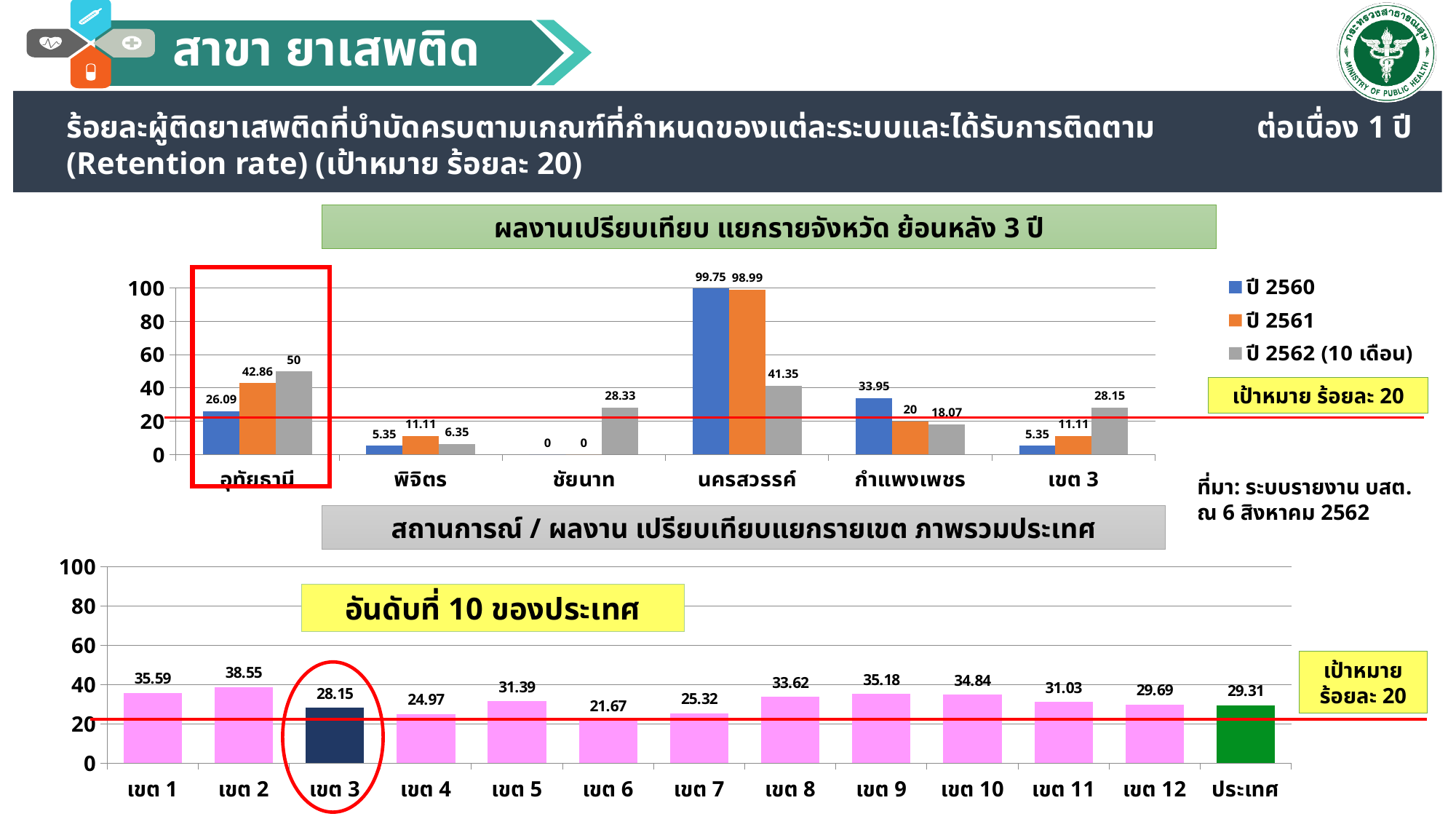
In the top chart (ผลงานเปรียบเทียบ แยกรายจังหวัด ย้อนหลัง 3 ปี), what is the value for นครสวรรค์ in ปี 2560? 99.75 In the bottom chart (สถานการณ์ / ผลงาน เปรียบเทียบแยกรายเขต ภาพรวมประเทศ), which is larger, the value for เขต 3 or the value for ประเทศ? ประเทศ In the bottom chart (สถานการณ์ / ผลงาน เปรียบเทียบแยกรายเขต ภาพรวมประเทศ), which category has the lowest value? เขต 6 In the bottom chart (สถานการณ์ / ผลงาน เปรียบเทียบแยกรายเขต ภาพรวมประเทศ), which category has the highest value? เขต 2 In the top chart (ผลงานเปรียบเทียบ แยกรายจังหวัด ย้อนหลัง 3 ปี), do the values for อุทัยธานี rise or fall from ปี 2560 to ปี 2562 (10 เดือน)? rise In the bottom chart (สถานการณ์ / ผลงาน เปรียบเทียบแยกรายเขต ภาพรวมประเทศ), how many categories are shown on the x axis? 13 In the top chart (ผลงานเปรียบเทียบ แยกรายจังหวัด ย้อนหลัง 3 ปี), what is the value for อุทัยธานี in ปี 2562 (10 เดือน)? 50 In the top chart (ผลงานเปรียบเทียบ แยกรายจังหวัด ย้อนหลัง 3 ปี), what is the difference between the ปี 2562 (10 เดือน) and ปี 2560 values for อุทัยธานี? 23.91 In the top chart (ผลงานเปรียบเทียบ แยกรายจังหวัด ย้อนหลัง 3 ปี), which category has the highest value for ปี 2561? นครสวรรค์ In the top chart (ผลงานเปรียบเทียบ แยกรายจังหวัด ย้อนหลัง 3 ปี), how many series does the legend list? 3 In the bottom chart (สถานการณ์ / ผลงาน เปรียบเทียบแยกรายเขต ภาพรวมประเทศ), what is the value for เขต 3? 28.15 In the top chart (ผลงานเปรียบเทียบ แยกรายจังหวัด ย้อนหลัง 3 ปี), what is the value for ชัยนาท in ปี 2561? 0